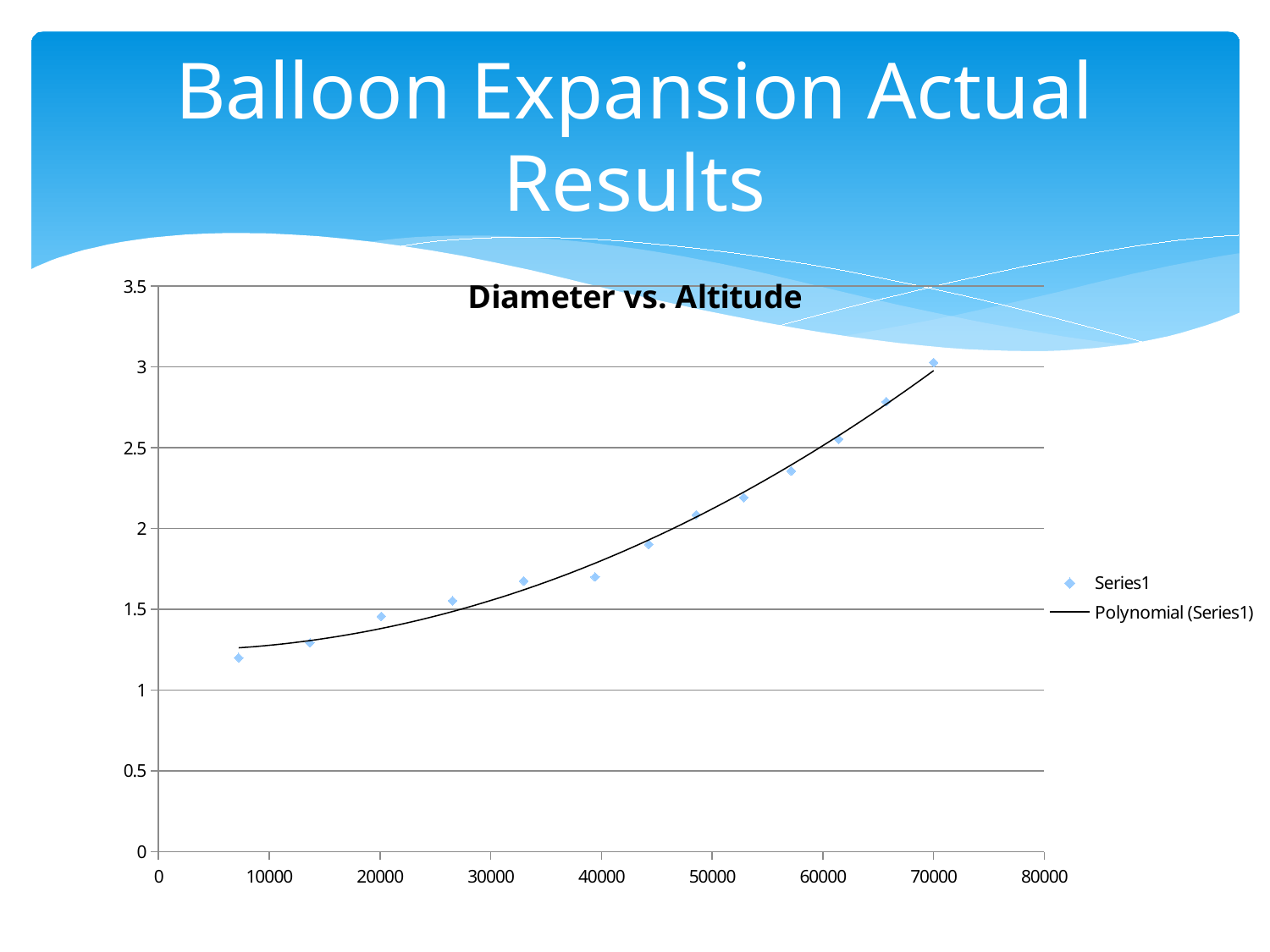
What is the highest value shown on the y axis? 3.5 How many entries does the chart's legend list? 2 Which data point has the highest value: the one near 70000 or the one near 7000 on the x axis? the one near 70000 What kind of chart is shown on the slide? scatter chart Is the value of the data point near 40000 on the x axis greater or less than 2? less Is the value of the data point near 65000 on the x axis greater or less than 2.5? greater Is the value of the data point near 20000 on the x axis greater or less than 1? greater What are the two entries listed in the chart's legend? Series1 and Polynomial (Series1) Do the plotted values rise or fall as altitude increases along the x axis? rise What is the title of the chart on the slide? Diameter vs. Altitude How many data points are plotted for Series1? 13